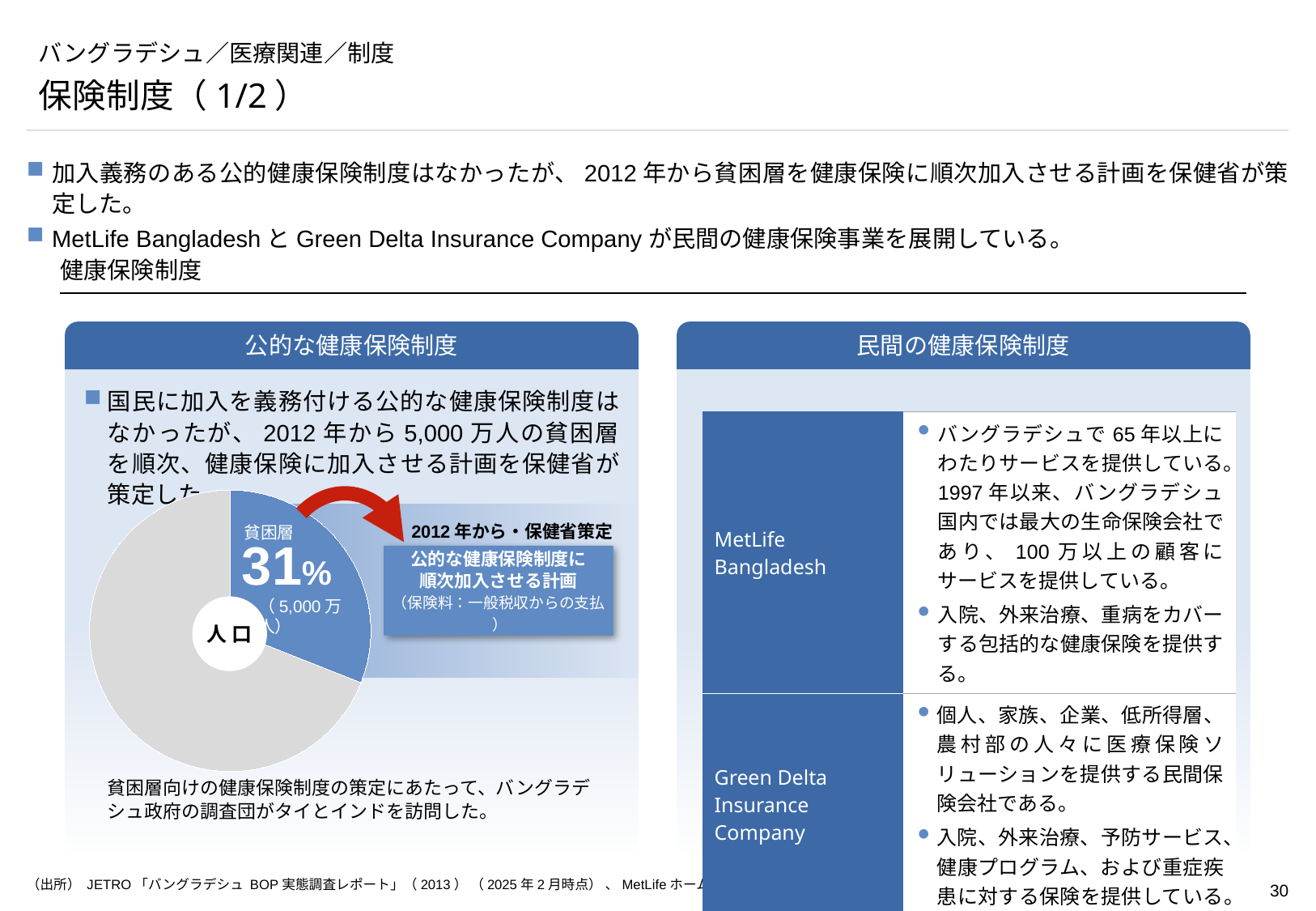
Is the share of the 貧困層 slice in the pie chart greater or less than 50%? less In the pie chart, what number of people is given in parentheses for the 貧困層 slice? 5,000万人 In the pie chart, what percentage share is shown for 貧困層? 31% Which slice of the pie chart is larger, the 貧困層 slice or the remaining unlabeled slice? the remaining unlabeled slice How many slices does the pie chart have? 2 What kind of chart is shown on the left side of the slide under 公的な健康保険制度? pie chart What is the name of the only labeled slice in the pie chart? 貧困層 What label appears in the centre of the pie chart? 人口 Which slice of the pie chart is the smallest? 貧困層 What colour is the 貧困層 slice in the pie chart? blue